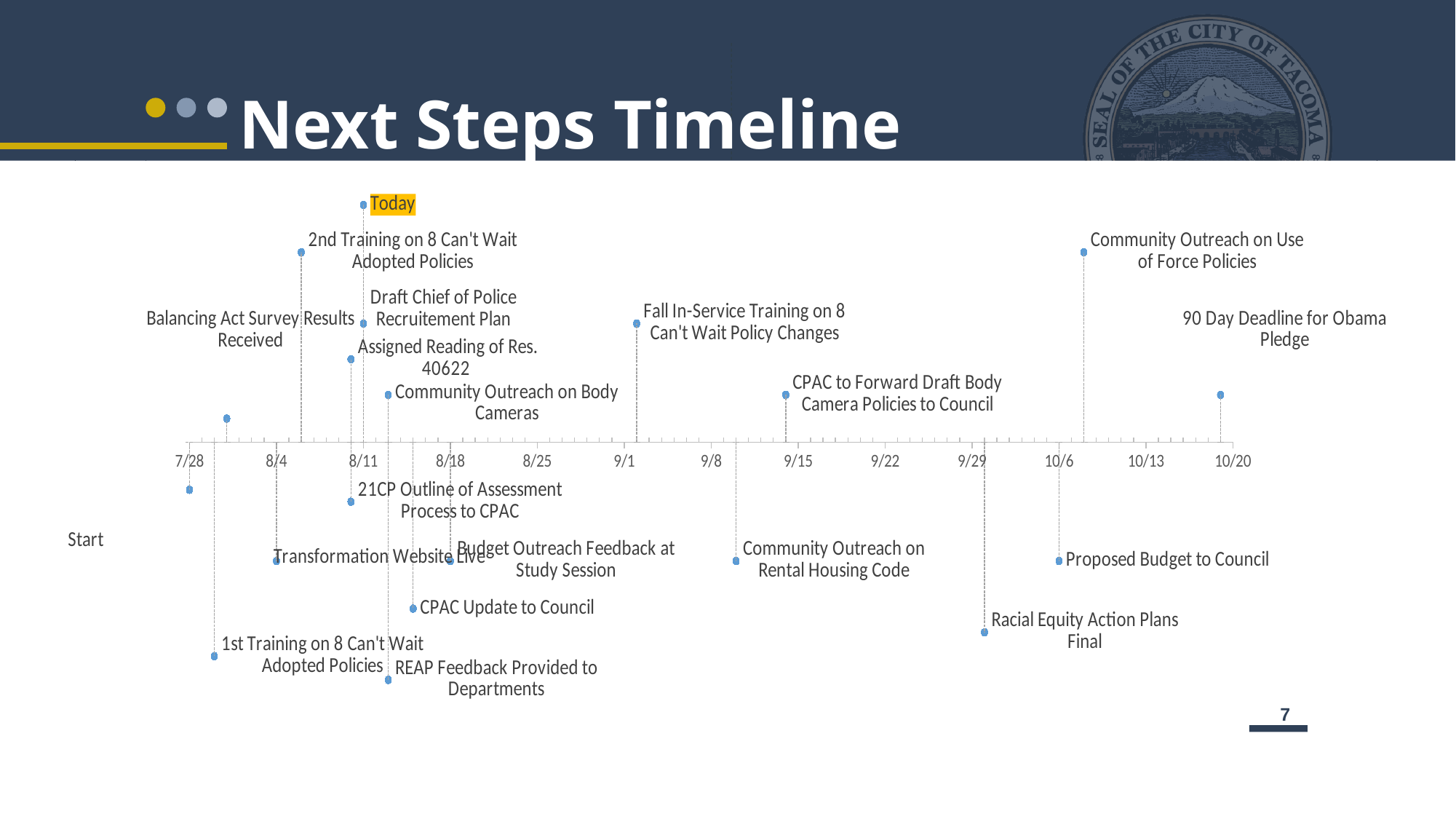
What kind of chart is shown on the slide? Timeline chart What is the last date label on the timeline axis? 10/20 Which event is the earliest on the timeline? Start Which event is the latest on the timeline? 90 Day Deadline for Obama Pledge Is 'Community Outreach on Rental Housing Code' before or after 9/8 on the timeline? after Which event marker is highlighted in yellow on the timeline? Today What is the title of the chart? Next Steps Timeline How many event markers are plotted on the timeline? 20 How many date tick labels are shown on the timeline axis? 13 What is the first date label on the timeline axis? 7/28 Which occurs earlier, 'Racial Equity Action Plans Final' or 'Proposed Budget to Council'? Racial Equity Action Plans Final Which occurs later, 'Fall In-Service Training on 8 Can't Wait Policy Changes' or 'CPAC to Forward Draft Body Camera Policies to Council'? CPAC to Forward Draft Body Camera Policies to Council